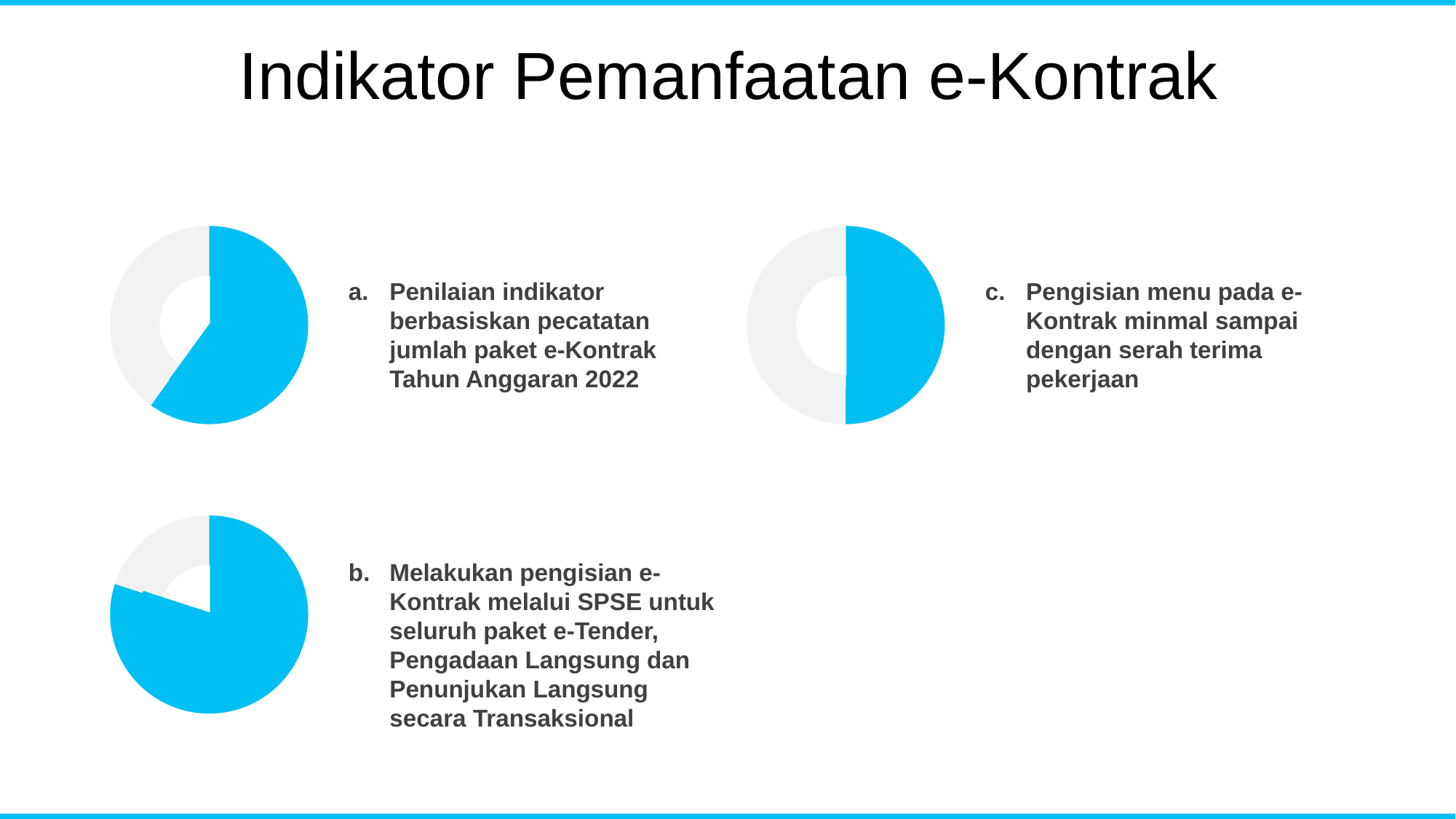
What kind of chart is the chart next to item c on the right? doughnut chart In the bottom-left chart next to item b, which slice is larger, the blue one or the grey one? the blue one What kind of chart is the bottom-left chart next to item b? pie chart How many charts are shown on the slide? 3 How many slices does the chart next to item c have? 2 How many slices does the top-left chart next to item a have? 2 How many slices does the bottom-left chart next to item b have? 2 In the top-left chart next to item a, which slice is larger, the blue one or the grey one? the blue one What kind of chart is the top-left chart next to item a? doughnut chart What two colours are used for the slices in the charts on the slide? blue and grey